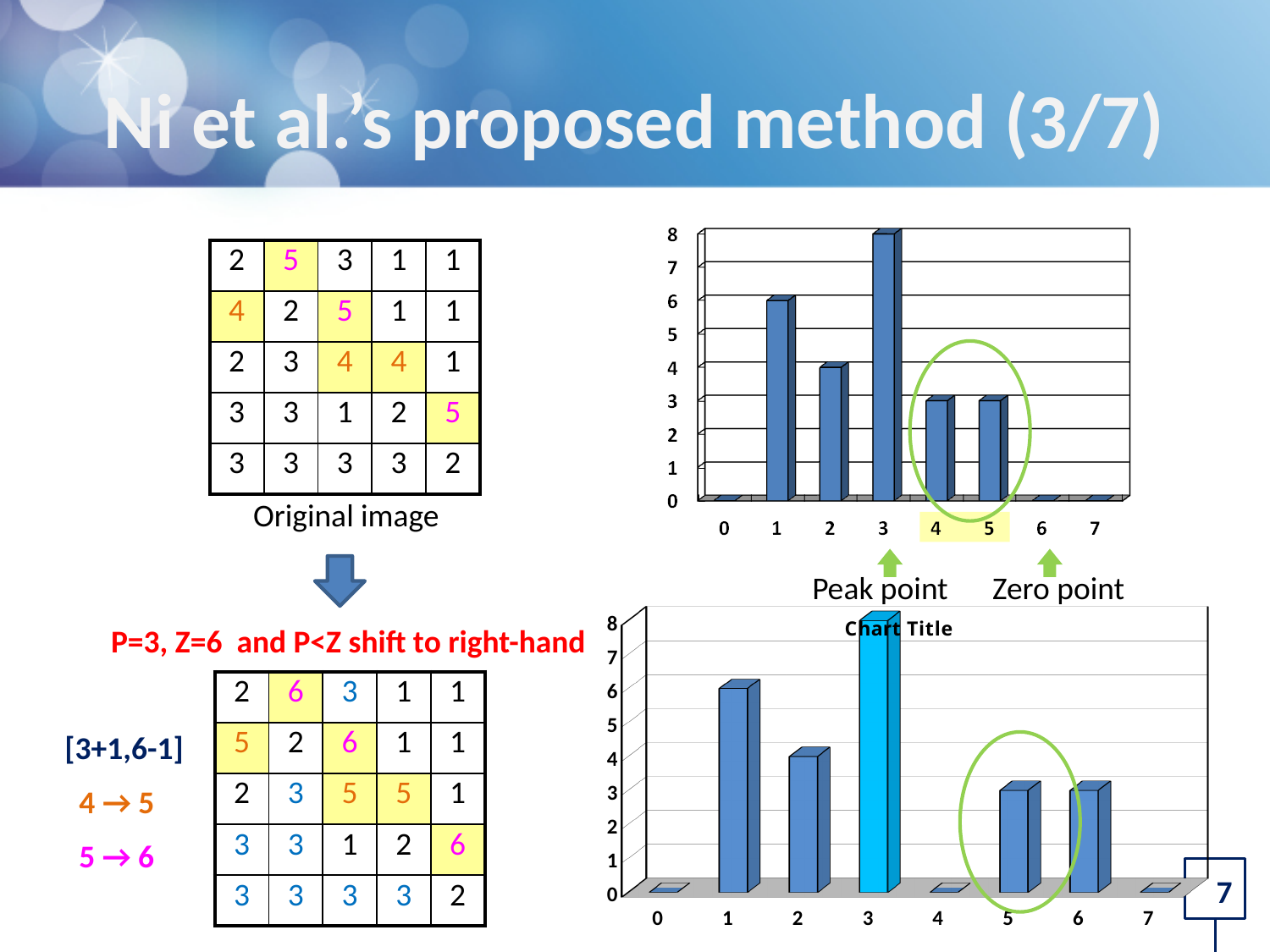
In the top chart, which is larger, the value for category 1 or the value for category 2? category 1 In the chart titled 'Chart Title', is the value for category 1 greater or less than 5? greater What kind of chart is the top chart? bar chart In the top chart, how many categories are shown on the x axis? 8 In the top chart, what is the value for category 3? 8 In the top chart, is the value for category 2 greater or less than 5? less What is the title of the bottom chart? Chart Title In the chart titled 'Chart Title', what is the value for category 3? 8 In the chart titled 'Chart Title', which category has the highest value? 3 In the top chart, which category has the highest value? 3 In the chart titled 'Chart Title', which is larger, the value for category 2 or the value for category 5? category 2 In the top chart, what is the value for category 1? 6